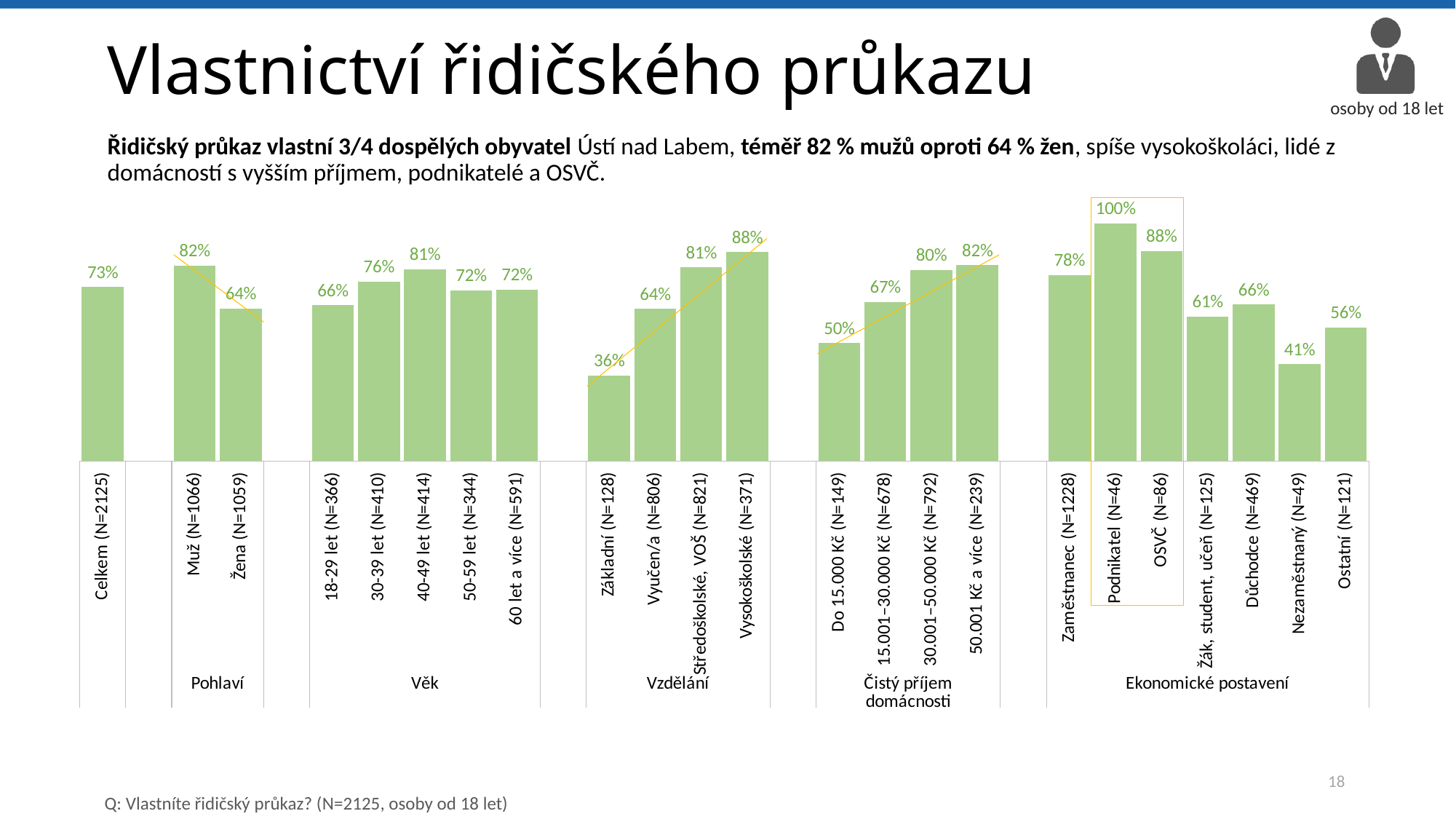
What is the difference between the values for Muž (N=1066) and Žena (N=1059)? 18% Which category has the highest value in the chart? Podnikatel (N=46) Which category has the lowest value in the chart? Základní (N=128) Do the values rise or fall across the Čistý příjem domácnosti categories from Do 15.000 Kč to 50.001 Kč a více? rise Within the Věk group, which category has the highest value? 40-49 let (N=414) Which is larger, the value for Vysokoškolské (N=371) or the value for Vyučen/a (N=806)? Vysokoškolské (N=371) What is the value for Základní (N=128)? 36% What kind of chart is shown on the slide? bar chart What is the value for Nezaměstnaný (N=49)? 41% How many bars are plotted in the chart? 23 What is the value for Žena (N=1059)? 64% What is the value for Celkem (N=2125)? 73%